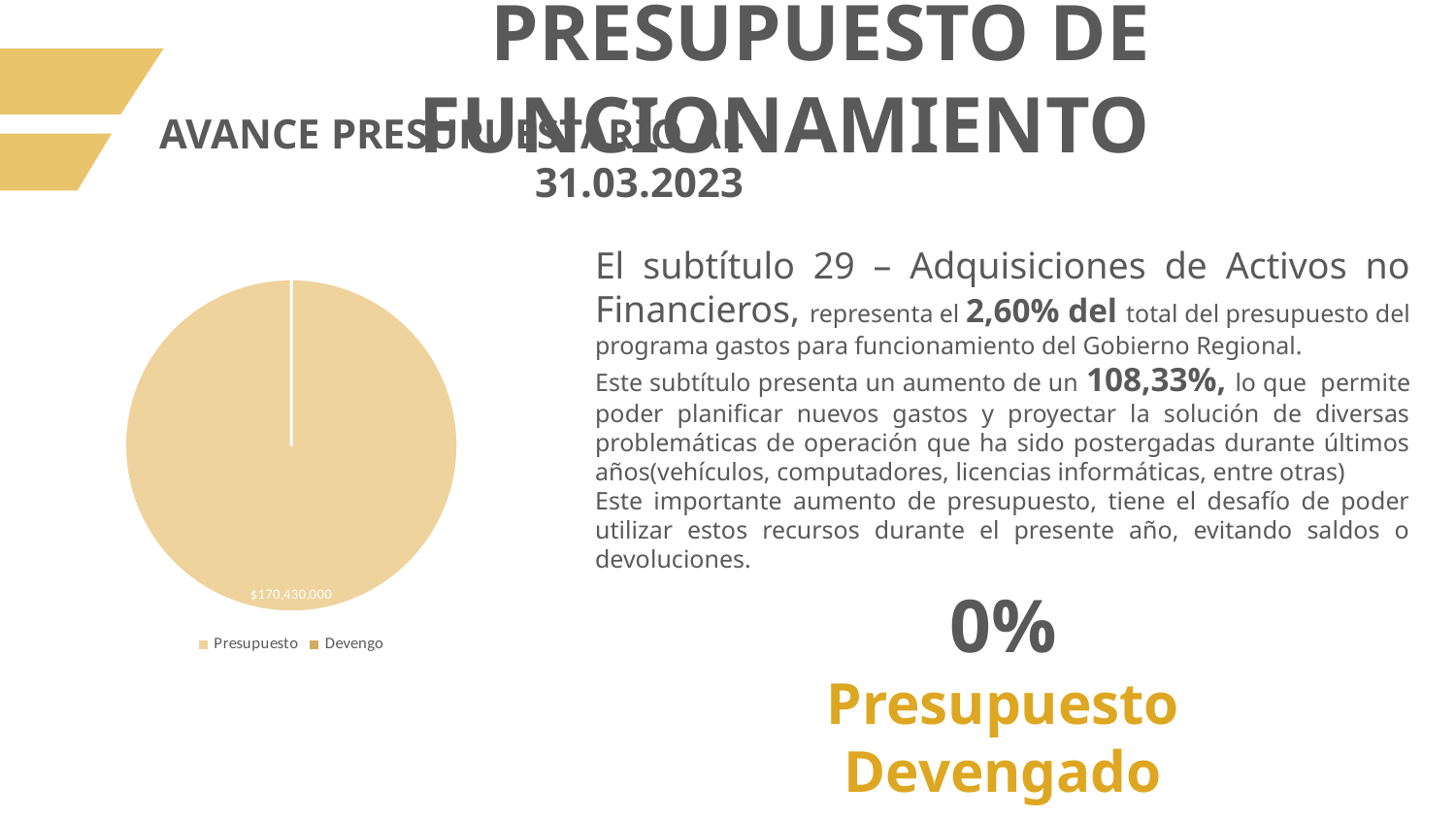
Which category is the largest in the pie chart? Presupuesto Which category is the smallest in the pie chart? Devengo What value is printed on the pie chart slice? $170,430,000 What is the value for Presupuesto in the pie chart? $170,430,000 What are the two entries in the chart legend? Presupuesto and Devengo How many slices are visibly drawn in the pie chart? 1 What share of the pie does Devengo (Presupuesto Devengado) represent? 0% What kind of chart is shown on the slide? pie chart Which category takes up the larger part of the pie, Presupuesto or Devengo? Presupuesto How many entries does the chart legend list? 2